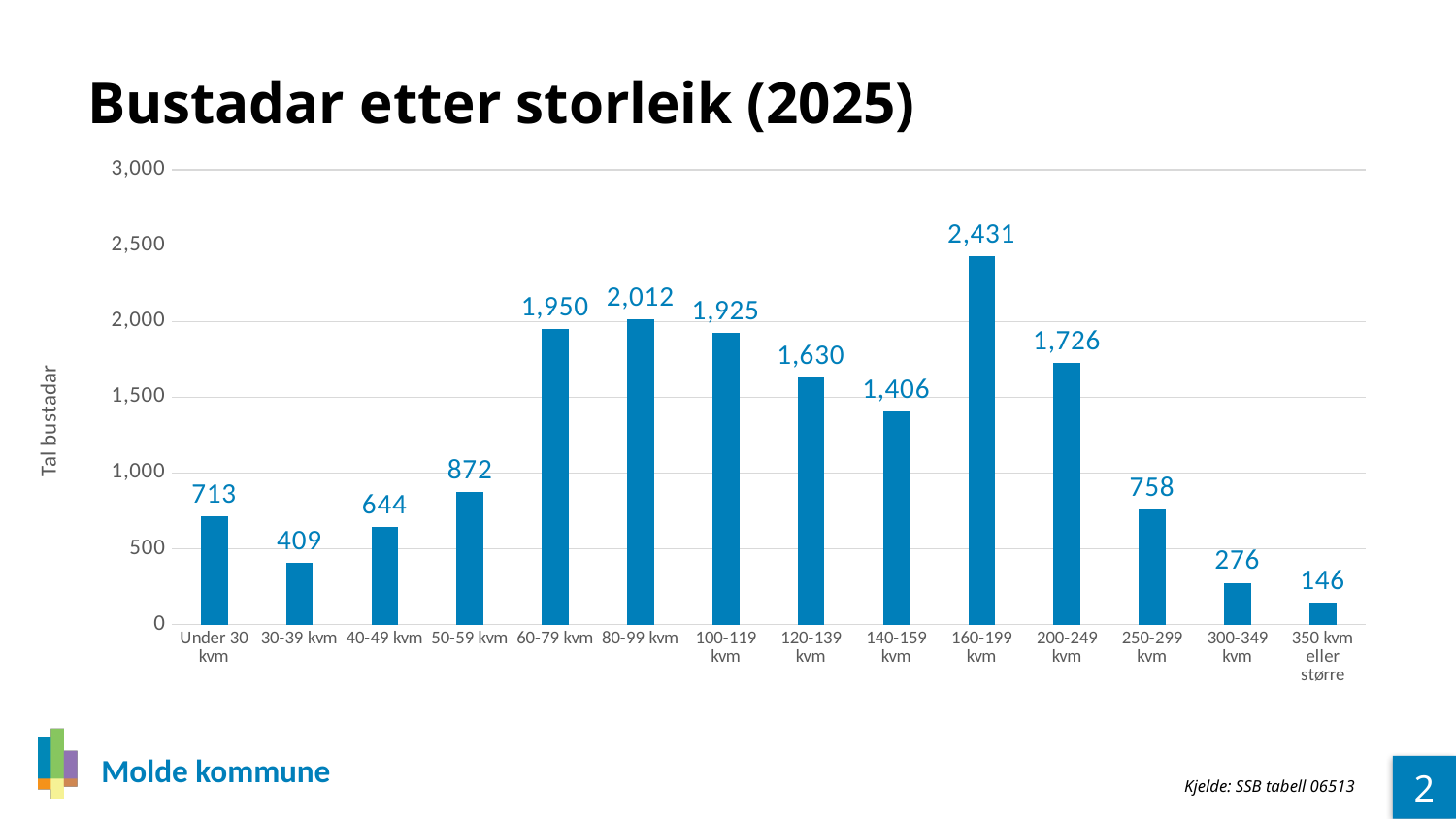
Which category has the highest value? 160-199 kvm What is the value for the 160-199 kvm category? 2,431 What is the title of the chart? Bustadar etter storleik (2025) How many categories are shown on the x axis? 14 What is the value for the 30-39 kvm category? 409 What is the difference between the values for 160-199 kvm and 200-249 kvm? 705 Which is larger, the value for 50-59 kvm or the value for 250-299 kvm? 50-59 kvm What is the value for the 350 kvm eller større category? 146 What kind of chart is shown on the slide? bar chart What is the difference between the values for 80-99 kvm and 60-79 kvm? 62 Is the value for 140-159 kvm greater or less than 1,500? less Which category has the lowest value? 350 kvm eller større